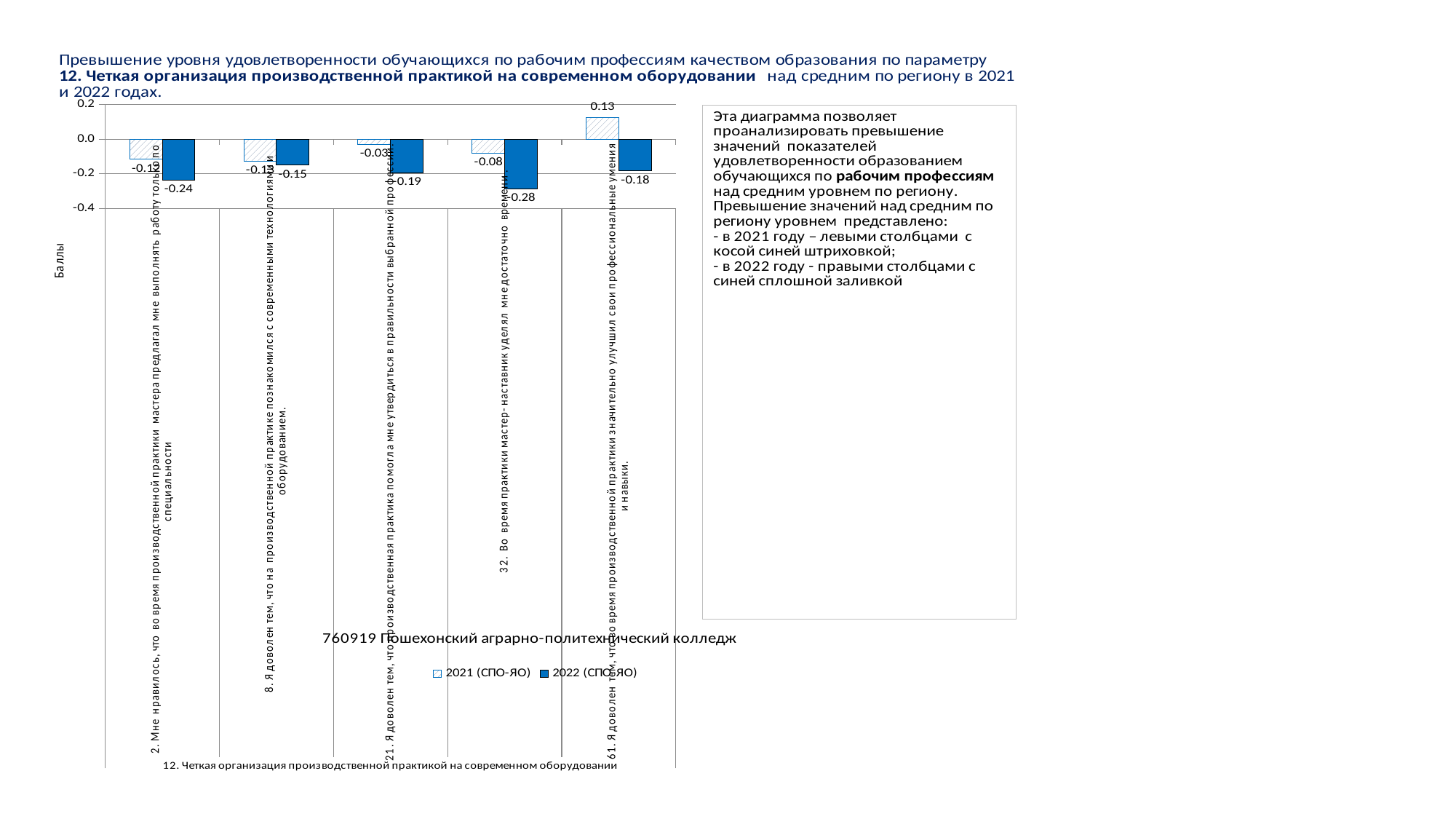
What is the 2022 (СПО-ЯО) value for category "2. Мне нравилось, что во время производственной практики мастера предлагал мне выполнять работу только по специальности"? -0.24 Which category has the lowest 2022 (СПО-ЯО) value? 32. Во время практики мастер-наставник уделял мне достаточно времени For category 32 (мастер-наставник уделял мне достаточно времени), what is the difference between the 2021 value (-0.08) and the 2022 value (-0.28)? 0.20 What is the 2021 (СПО-ЯО) value for category "61. Я доволен тем, что во время производственной практики значительно улучшил свои профессиональные умения и навыки"? 0.13 How many categories (questions) are plotted on the x axis of the chart? 5 What is the 2022 (СПО-ЯО) value for category "32. Во время практики мастер-наставник уделял мне достаточно времени"? -0.28 What is the 2022 (СПО-ЯО) value for category "8. Я доволен тем, что на производственной практике познакомился с современными технологиями и оборудованием"? -0.15 Which category has the highest 2021 (СПО-ЯО) value? 61. Я доволен тем, что во время производственной практики значительно улучшил свои профессиональные умения и навыки What is the 2021 (СПО-ЯО) value for category "21. Я доволен тем, что производственная практика помогла мне утвердиться в правильности выбранной профессии"? -0.03 What is the title shown on the chart? 760919 Пошехонский аграрно-политехнический колледж What kind of chart is shown on the slide? bar chart How many series does the chart legend list? 2